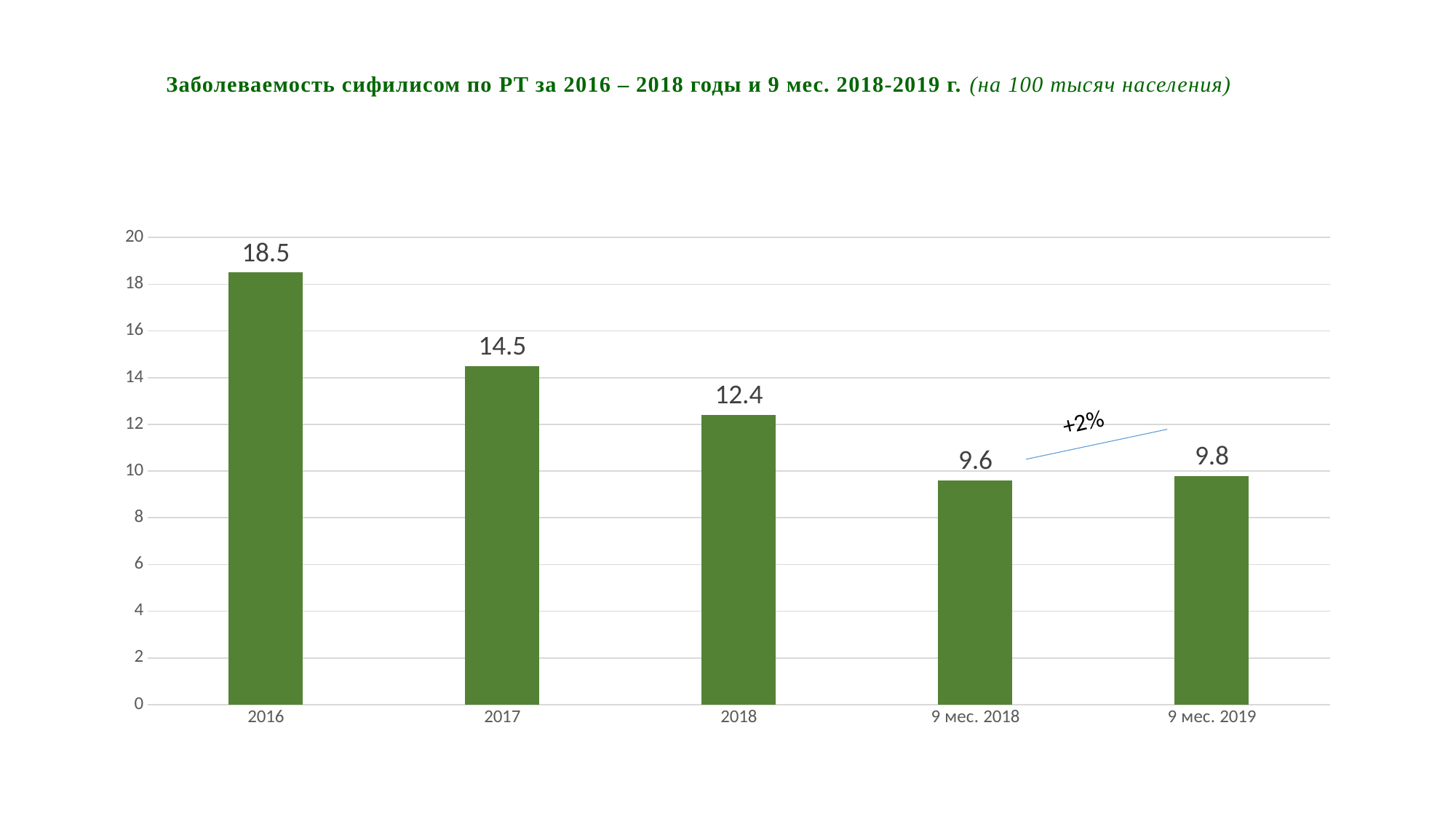
What percentage change is annotated between 9 мес. 2018 and 9 мес. 2019? +2% What is the value for 2017? 14.5 Which category has the lowest value? 9 мес. 2018 Is the value for 2018 greater or less than 10? greater Which is larger, the value for 2017 or the value for 2018? 2017 Which category has the highest value? 2016 What kind of chart is shown on the slide? bar chart Do the values rise or fall from 2016 to 2018? fall How many bars are shown in the chart? 5 What is the value for 9 мес. 2019? 9.8 What is the difference between the values for 2016 and 2018? 6.1 What is the value for 2016? 18.5